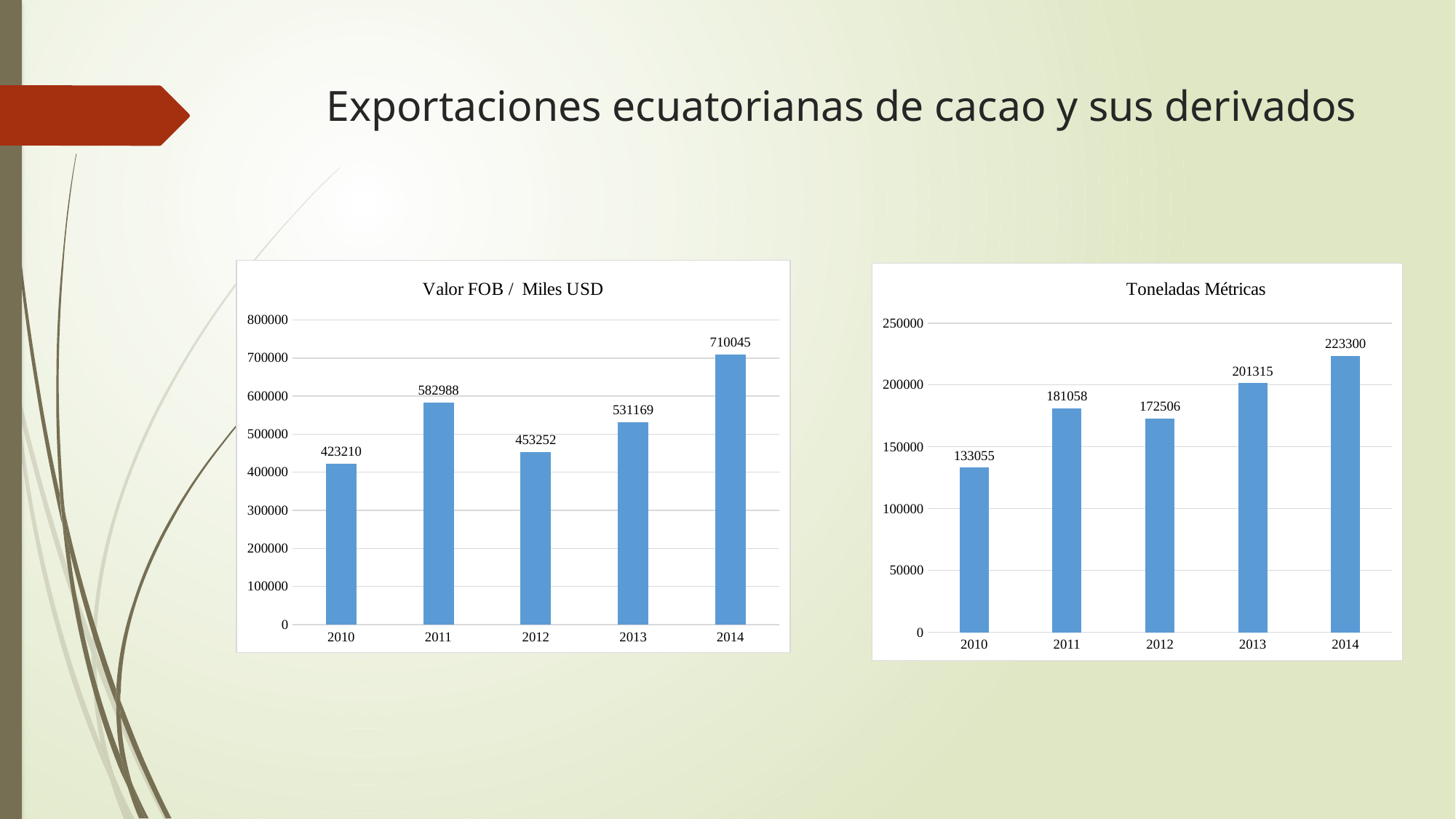
In the 'Toneladas Métricas' chart, do the values rise or fall from 2012 to 2014? rise In the 'Toneladas Métricas' chart, what is the value for 2013? 201315 What is the title of the chart on the left of the slide? Valor FOB / Miles USD What kind of chart is the 'Toneladas Métricas' chart? bar chart In the 'Valor FOB / Miles USD' chart, what is the difference between the values for 2014 and 2010? 286835 In the 'Valor FOB / Miles USD' chart, which is larger, the value for 2011 or the value for 2013? 2011 In the 'Valor FOB / Miles USD' chart, what is the value for 2012? 453252 In the 'Toneladas Métricas' chart, which year has the lowest value? 2010 In the 'Toneladas Métricas' chart, what is the difference between the values for 2011 and 2012? 8552 In the 'Valor FOB / Miles USD' chart, which year has the highest value? 2014 In the 'Toneladas Métricas' chart, is the value for 2010 greater or less than 150000? less How many years are shown on the x axis of the 'Valor FOB / Miles USD' chart? 5